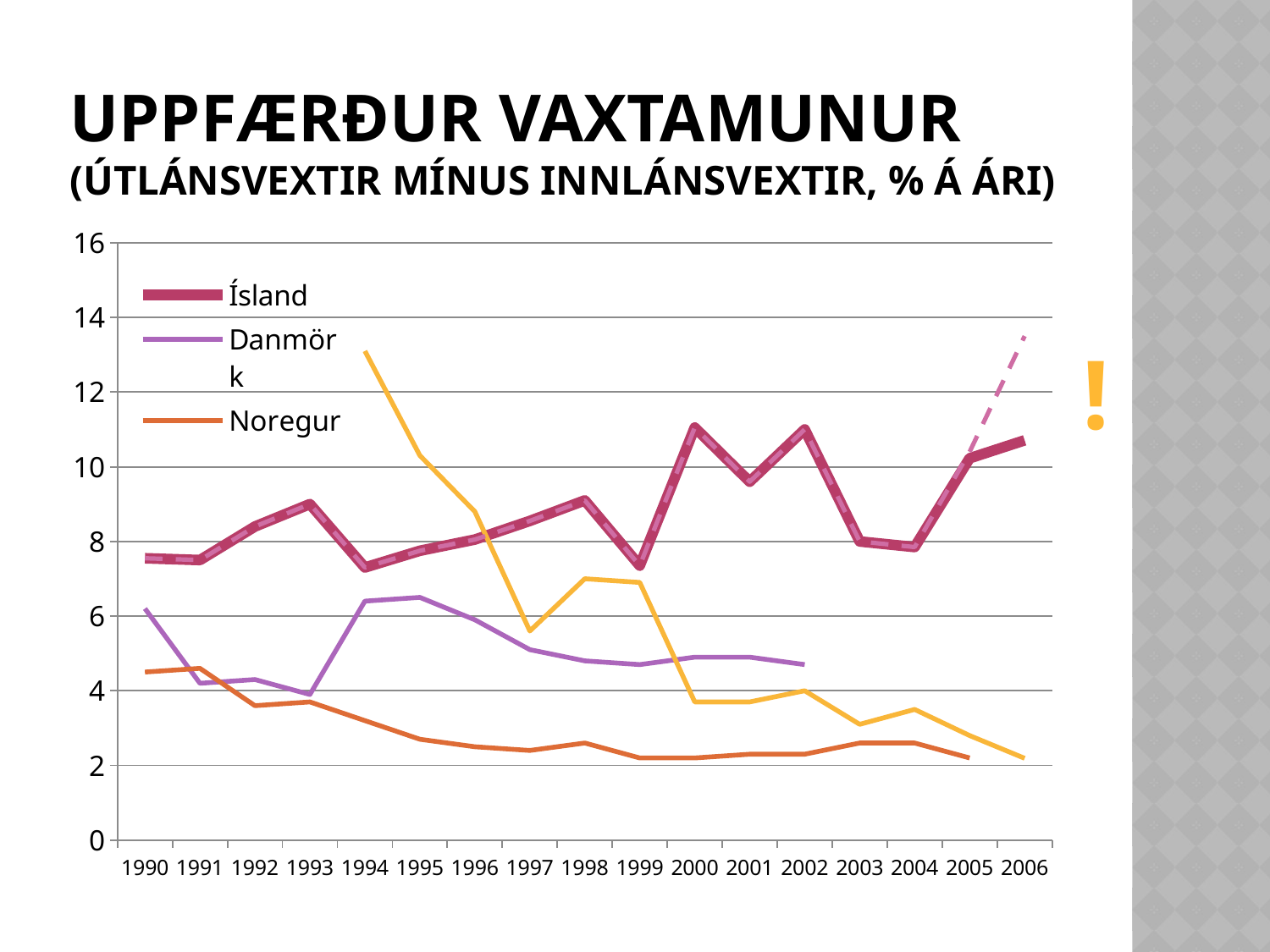
Which of the legend series has the lowest value in 2000? Noregur In 1995, which is larger, the value for Danmörk or the value for Noregur? Danmörk How many years are shown on the x axis? 17 What kind of chart is shown on the slide? line chart In 2000, which is larger, the value for Ísland or the value for Noregur? Ísland Is the value for Ísland in 1994 greater or less than 8? less Is the value for Danmörk in 1995 greater or less than 6? greater How many series does the legend list? 3 Is the value for Ísland in 2000 greater or less than 10? greater Which series does the legend list first? Ísland Does the Noregur line generally rise or fall from 1990 to 2005? fall